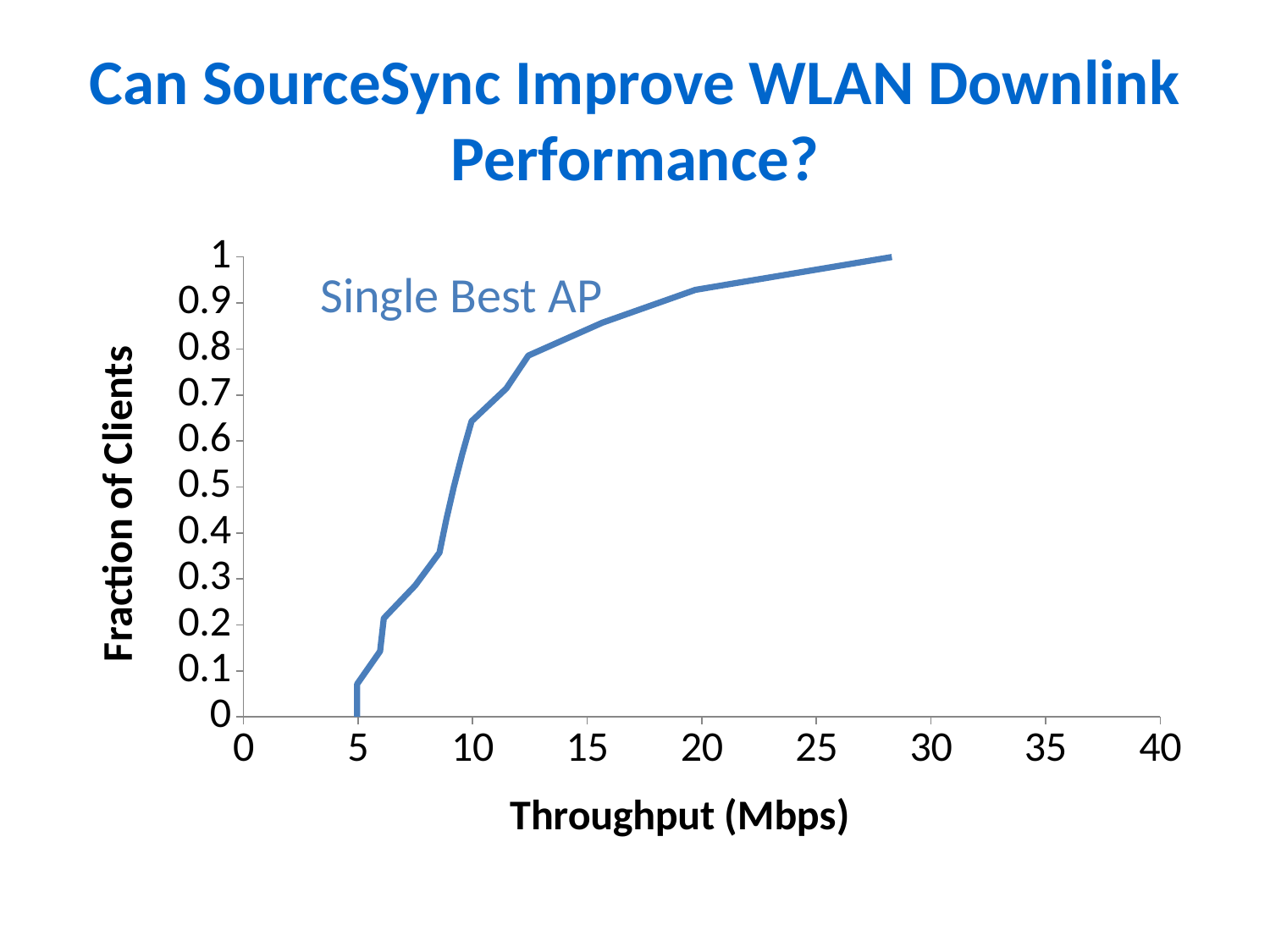
Is the Fraction of Clients at a throughput of 20 Mbps greater or less than 0.8? greater What is the maximum value shown on the x axis? 40 Is the Fraction of Clients at a throughput of 10 Mbps greater or less than 0.5? greater What is the label of the y axis? Fraction of Clients What is the label of the x axis? Throughput (Mbps) Is the highest throughput reached by the Single Best AP curve greater or less than 30 Mbps? less What kind of chart is shown on the slide? line chart Does the Fraction of Clients rise or fall as Throughput increases along the x axis? rise